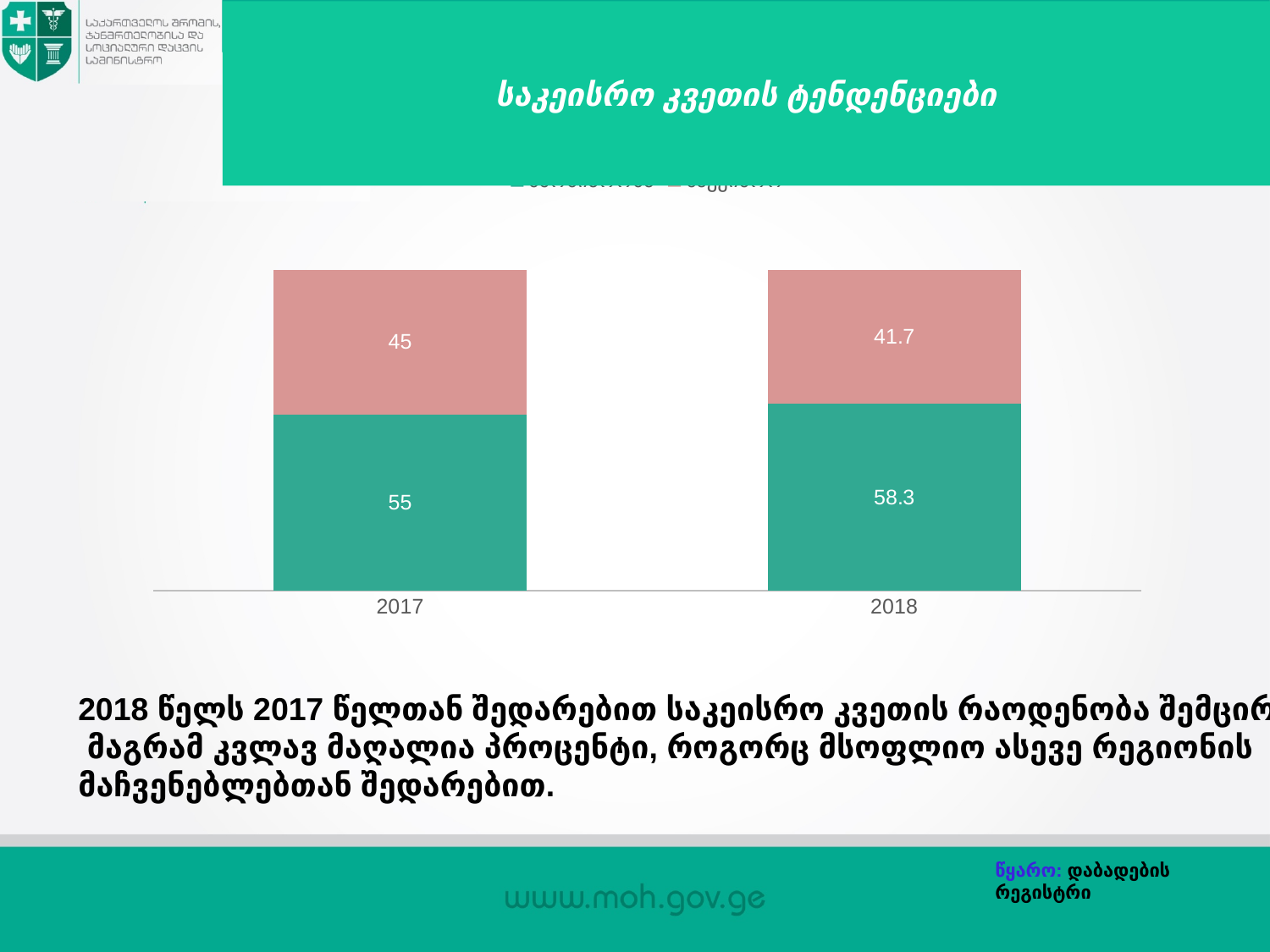
What is the value of the pink segment for 2018? 41.7 What is the value of the green segment for 2018? 58.3 What is the difference between the green segment values for 2018 and 2017? 3.3 What is the value of the green segment for 2017? 55 What is the value of the pink segment for 2017? 45 Does the green segment value rise or fall from 2017 to 2018? Rise What is the title of the chart on the slide? საკეისრო კვეთის ტენდენციები Which is larger, the pink segment for 2017 or the pink segment for 2018? 2017 What kind of chart is shown on the slide? Stacked bar chart How many categories are shown on the x axis? 2 What is the total of the stacked bar for 2018? 100 Does the pink segment value rise or fall from 2017 to 2018? Fall